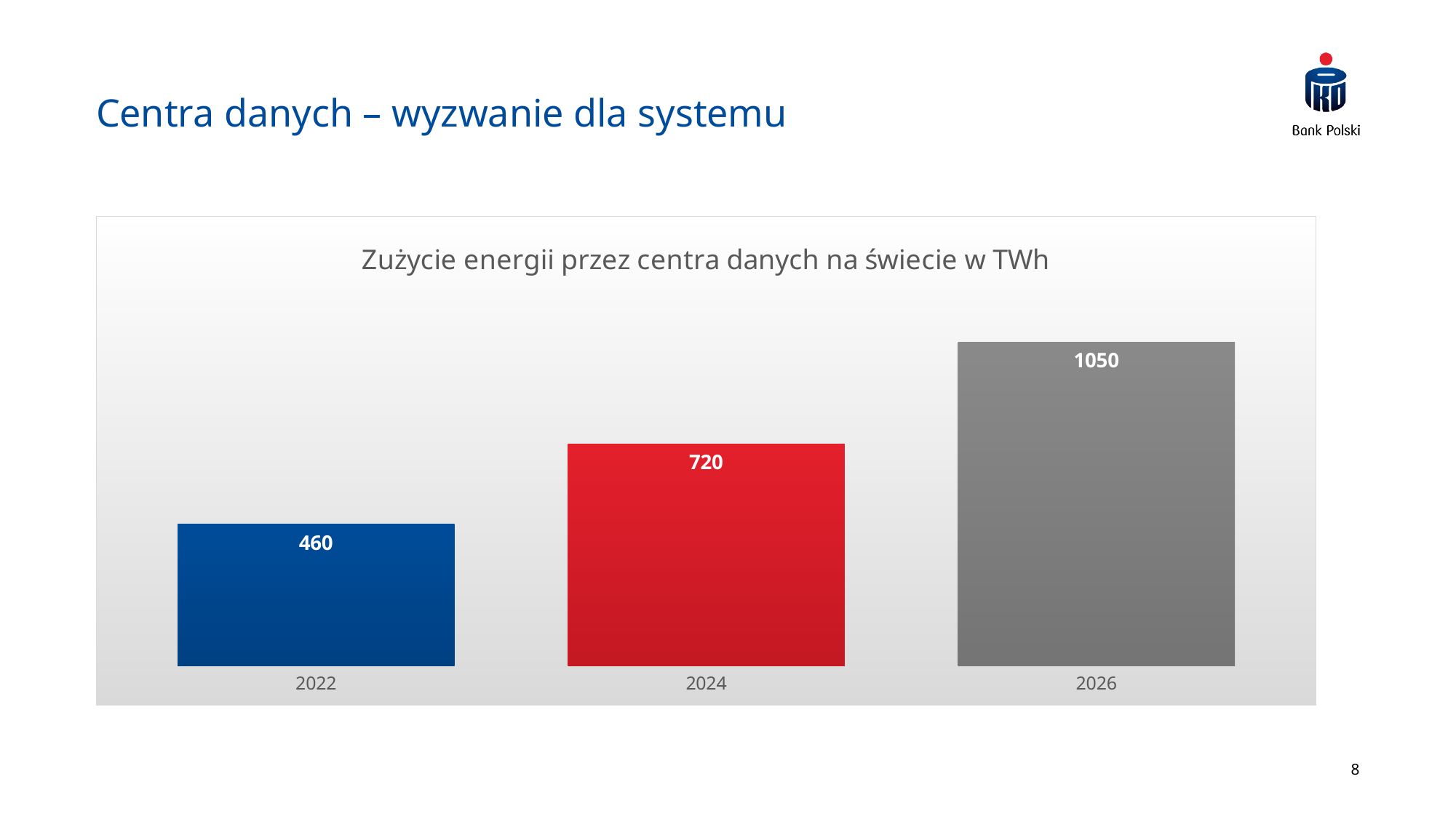
Do the values rise or fall from 2022 to 2026? rise What is the title of the chart? Zużycie energii przez centra danych na świecie w TWh Which year has the lowest value? 2022 How many years are shown on the x axis? 3 What is the difference between the values for 2026 and 2022? 590 What is the value for 2022? 460 Which is larger, the value for 2024 or the value for 2026? 2026 What is the difference between the values for 2024 and 2022? 260 What is the value for 2026? 1050 What kind of chart is this? bar chart What is the value for 2024? 720 Which year has the highest value? 2026